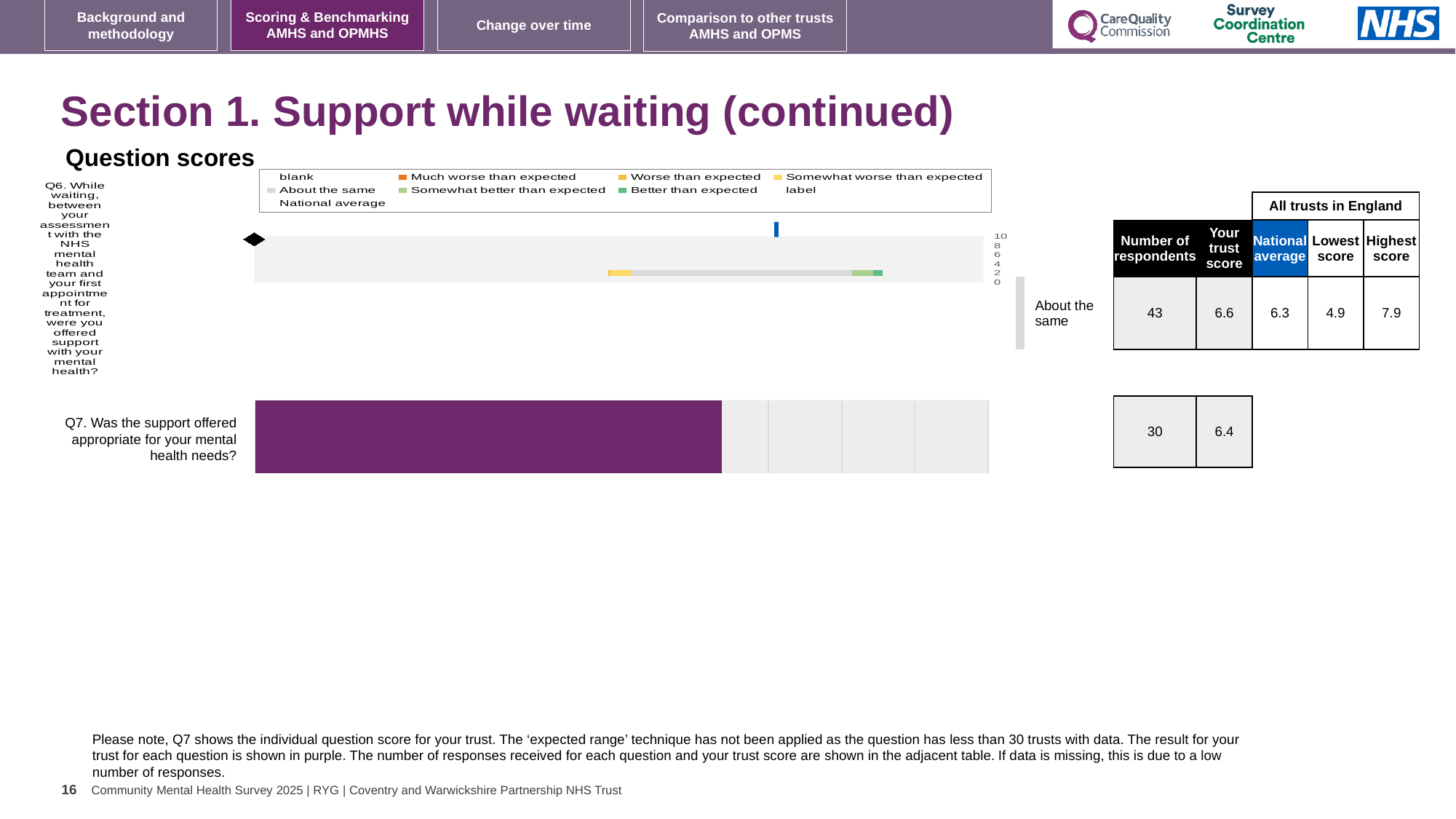
What is the trust score for Q6 shown in the table next to the chart? 6.6 What is the difference between the trust score and the national average for Q6? 0.3 What is the highest score among all trusts in England for Q6? 7.9 How many respondents answered Q7? 30 For Q6, which is larger: the trust score or the national average? Trust score What is the trust score for Q7? 6.4 What colour is the bar plotted for Q7? Purple What is the difference between the highest and lowest scores for Q6 across all trusts in England? 3.0 What category label is shown beside the Q6 chart describing how the trust compares to expected? About the same What is the lowest score among all trusts in England for Q6? 4.9 How many respondents answered Q6? 43 What is the national average score for Q6? 6.3